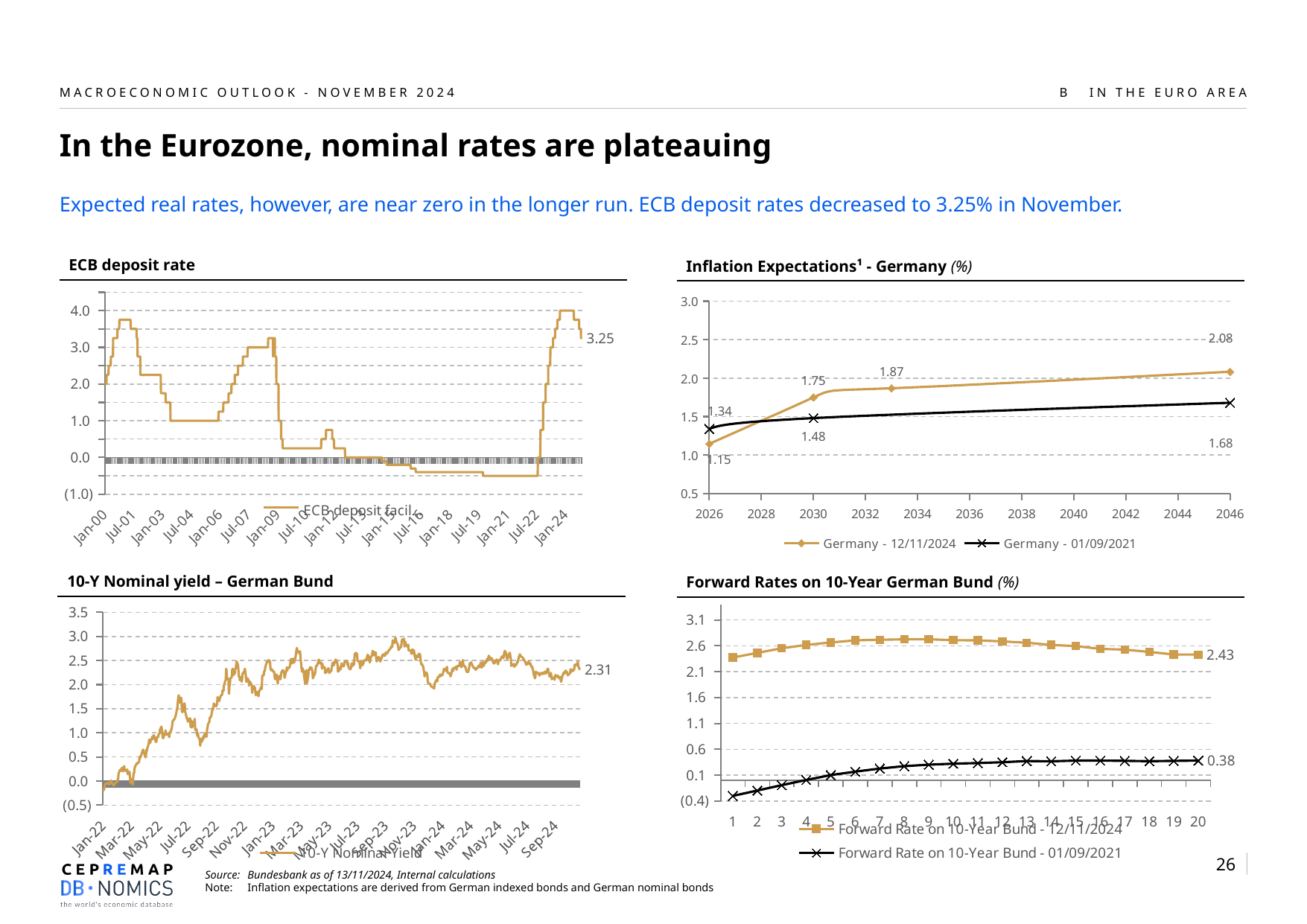
On the Inflation Expectations - Germany chart, does the Germany - 12/11/2024 series rise or fall from 2026 to 2046? rise On the Inflation Expectations - Germany chart, which series has the higher value in 2026: Germany - 12/11/2024 or Germany - 01/09/2021? Germany - 01/09/2021 What kind of chart is the ECB deposit rate chart? line chart On the Forward Rates on 10-Year German Bund chart, how many points are shown on the x axis? 20 On the Inflation Expectations - Germany chart, what is the value for Germany - 12/11/2024 in 2046? 2.08 On the 10-Y Nominal yield – German Bund chart, what is the latest value labelled at the end of the line? 2.31 On the Inflation Expectations - Germany chart, what is the value for Germany - 01/09/2021 in 2046? 1.68 On the Inflation Expectations - Germany chart, how many series does the legend list? 2 On the Forward Rates on 10-Year German Bund chart, what is the value at point 20 for Forward Rate on 10-Year Bund - 12/11/2024? 2.43 On the Forward Rates on 10-Year German Bund chart, what is the difference at point 20 between the 12/11/2024 series (2.43) and the 01/09/2021 series (0.38)? 2.05 On the ECB deposit rate chart, what is the latest value labelled at the end of the line? 3.25 On the Inflation Expectations - Germany chart, what is the difference between the two series in 2046 (2.08 vs 1.68)? 0.40